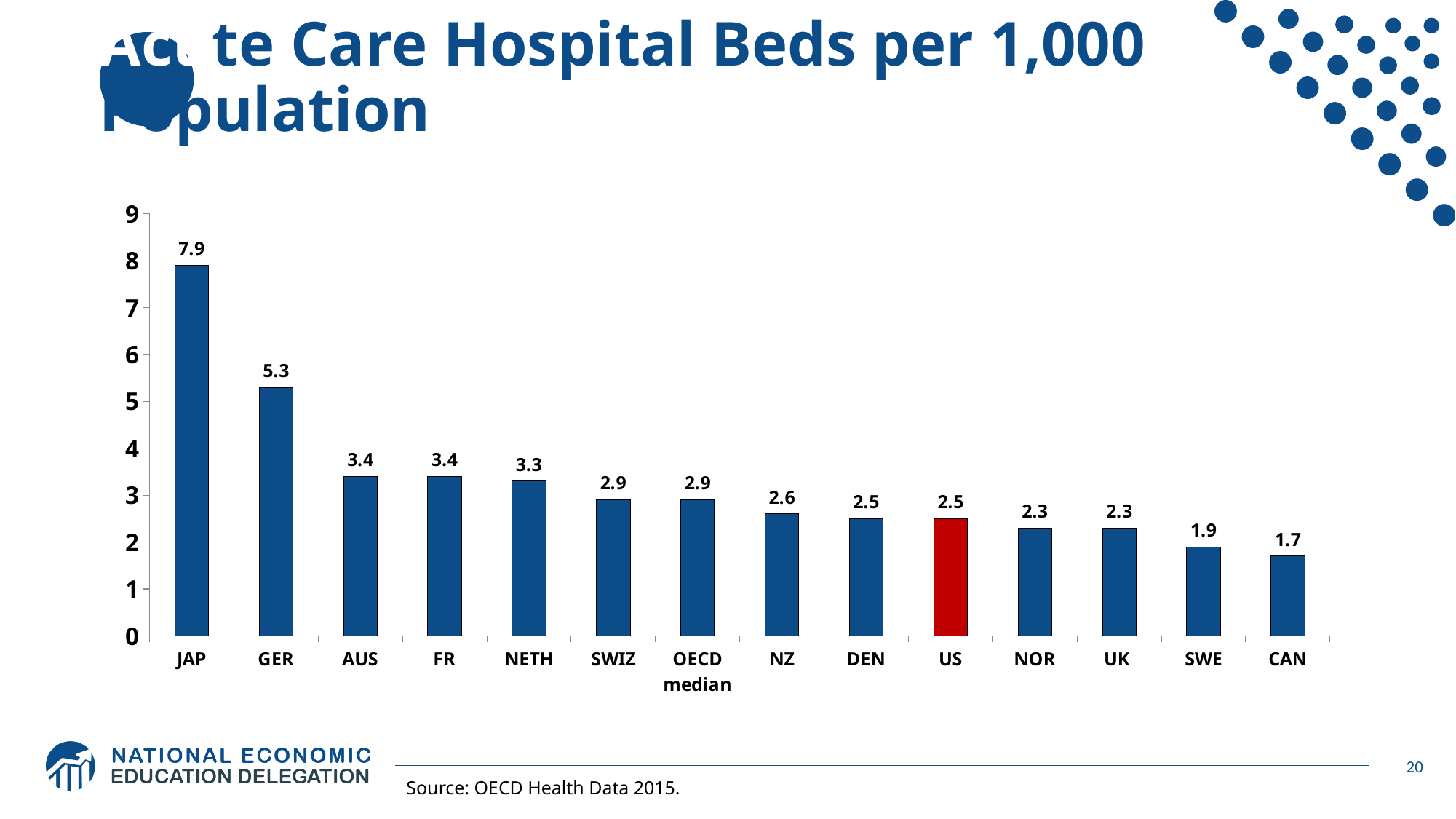
What is the difference between the values for the OECD median and the US? 0.4 Which bar is coloured red instead of blue? US Which country has the highest number of acute care hospital beds per 1,000 population? JAP What is the value for JAP? 7.9 Which country has the lowest number of acute care hospital beds per 1,000 population? CAN Which has a larger value, NZ or SWE? NZ What is the difference between the values for JAP and GER? 2.6 What is the value for the US? 2.5 How many bars are shown in the chart? 14 Which has a larger value, GER or AUS? GER What is the value for the OECD median? 2.9 What kind of chart is shown on the slide? Bar chart